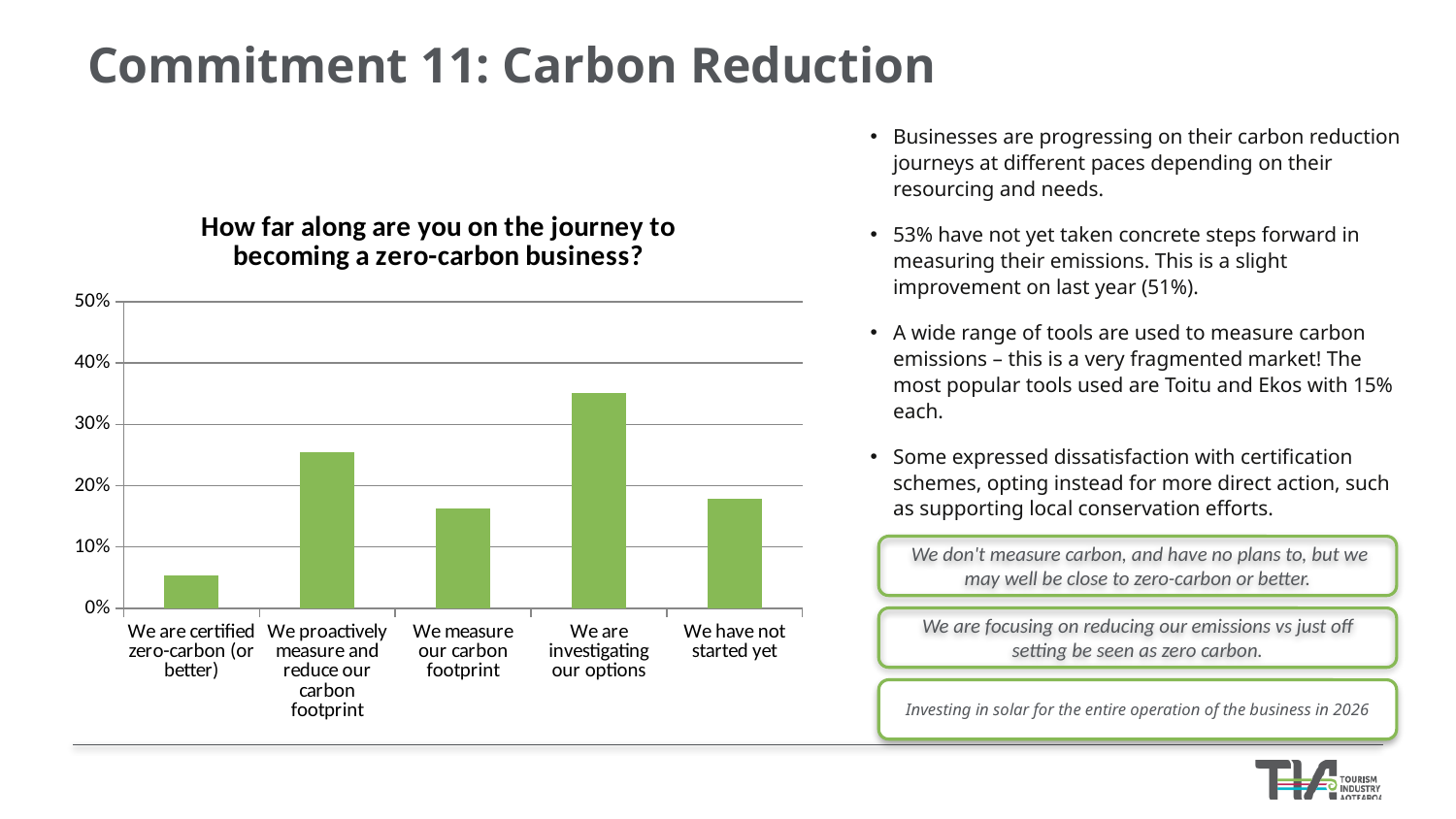
What is the highest value shown on the y axis of the chart? 50% What is the title of the chart? How far along are you on the journey to becoming a zero-carbon business? Which is larger: the value for "We proactively measure and reduce our carbon footprint" or the value for "We measure our carbon footprint"? We proactively measure and reduce our carbon footprint Is the value for "We are investigating our options" greater or less than 30%? greater Is the value for "We measure our carbon footprint" greater or less than 10%? greater Is the value for "We have not started yet" greater or less than 20%? less Which category has the lowest value? We are certified zero-carbon (or better) How many categories are shown on the x axis of the chart? 5 Which category has the highest value? We are investigating our options What kind of chart is shown on the slide? bar chart